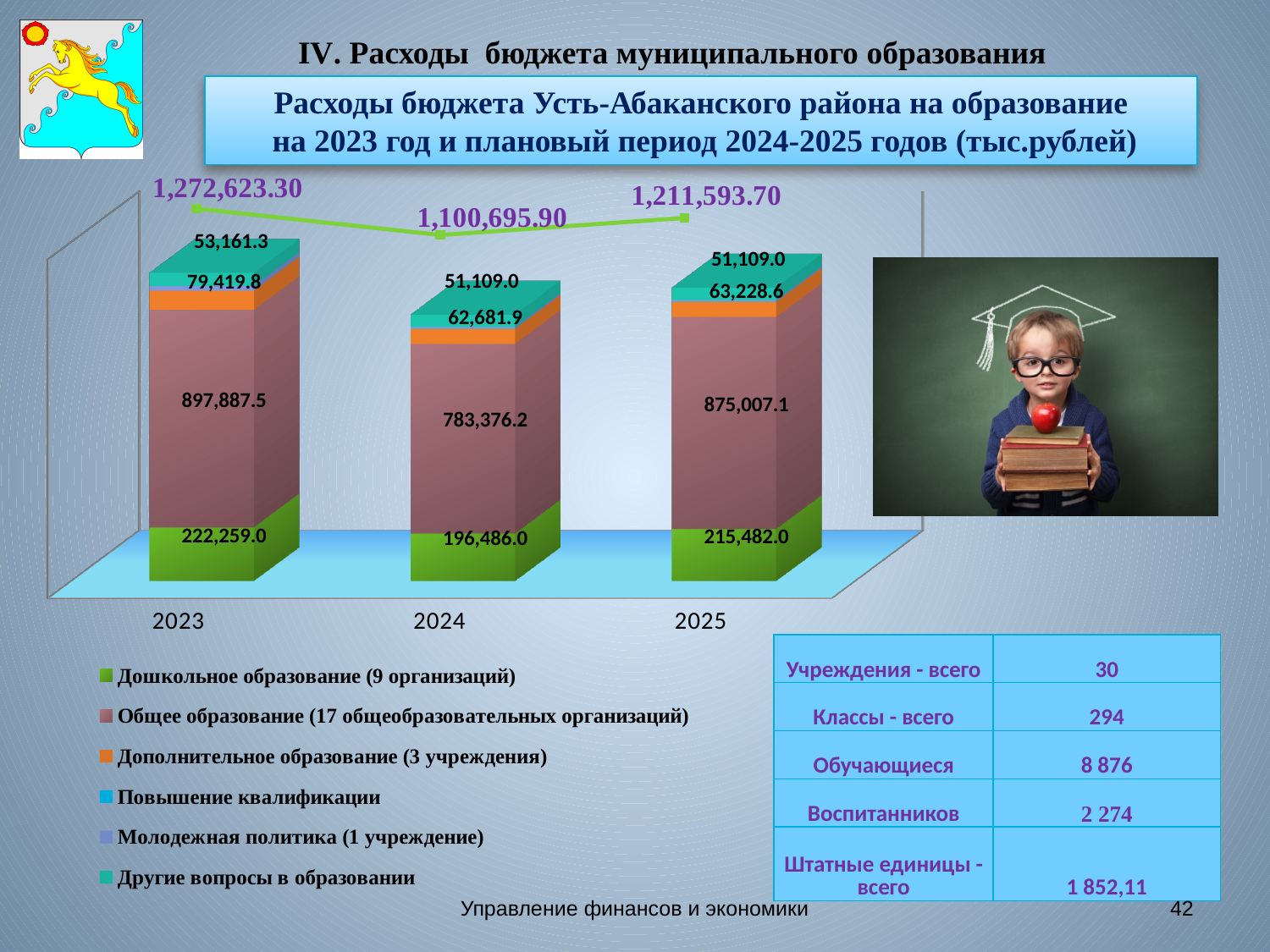
Which year has the highest total education expenditure? 2023 What is the total education expenditure shown for 2025? 1,211,593.70 What is the value for Общее образование (17 общеобразовательных организаций) in 2024? 783,376.2 By how much does the value for Дошкольное образование in 2023 exceed the value in 2024? 25,773.0 What is the value for Дошкольное образование (9 организаций) in 2023? 222,259.0 How many series does the chart legend list? 6 What is the difference between the Общее образование values for 2025 and 2024? 91,630.9 Which year has the larger value for Общее образование: 2023 or 2025? 2023 Which year has the lowest total education expenditure? 2024 How does the total education expenditure change from 2023 to 2024 to 2025? It falls from 2023 to 2024, then rises in 2025 How many years (categories) are shown on the x axis of the chart? 3 What kind of chart is used to show the education budget expenditures by year? Stacked bar chart